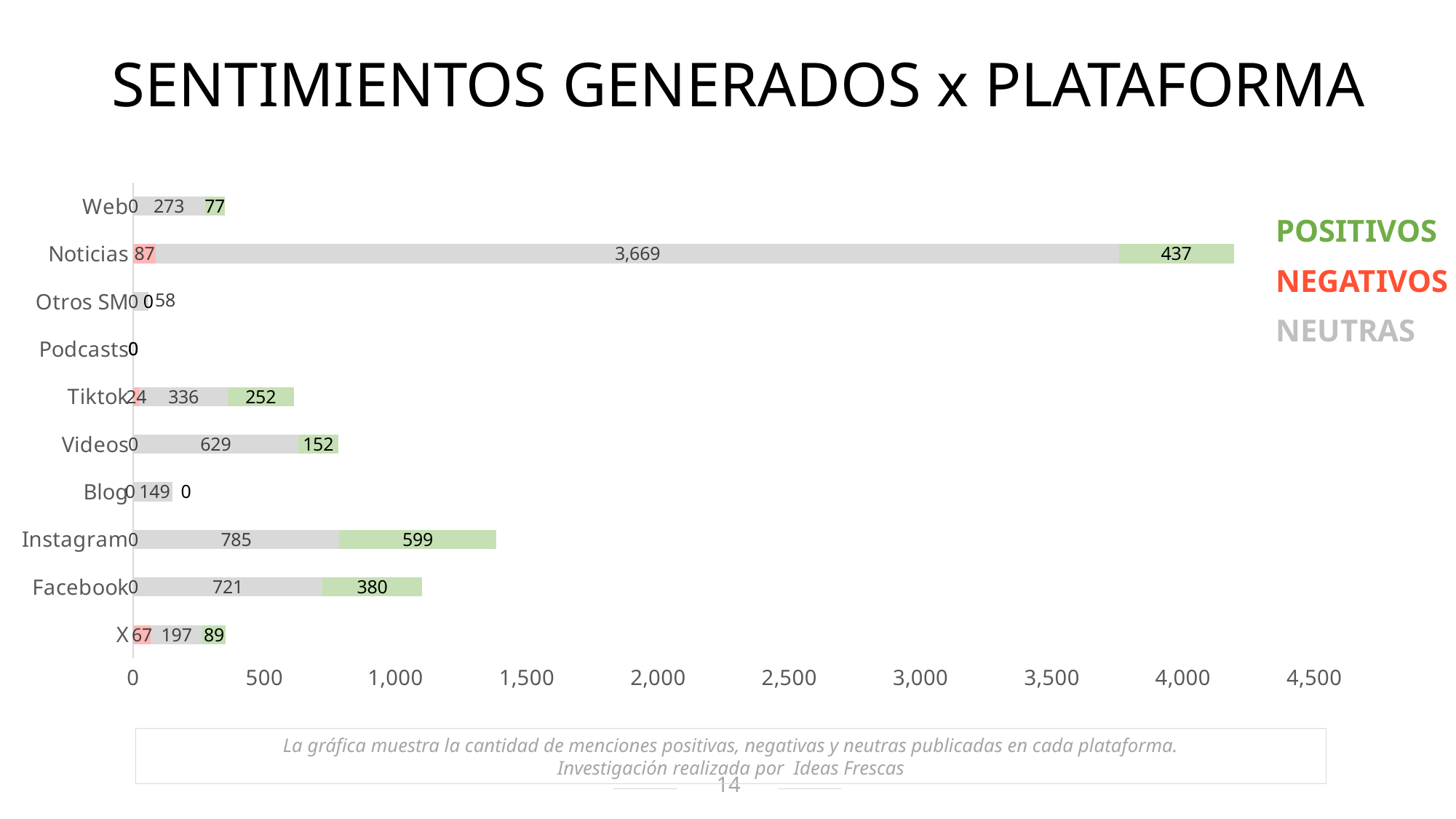
How many positive (POSITIVOS) mentions does Instagram have? 599 What is the difference between the positive mentions for Instagram and for Facebook? 219 How many platforms are listed on the chart? 10 Which has more neutral mentions, Videos or Facebook? Facebook How many neutral (NEUTRAS) mentions does Noticias have? 3,669 Which platform has the highest number of positive mentions? Instagram What kind of chart is shown on the slide? Stacked bar chart How many series does the legend list? 3 What is the total number of mentions (all sentiments) for Facebook? 1,101 What is the total number of mentions (all sentiments) for Tiktok? 612 Which platform has the highest number of neutral mentions? Noticias How many negative (NEGATIVOS) mentions does X have? 67